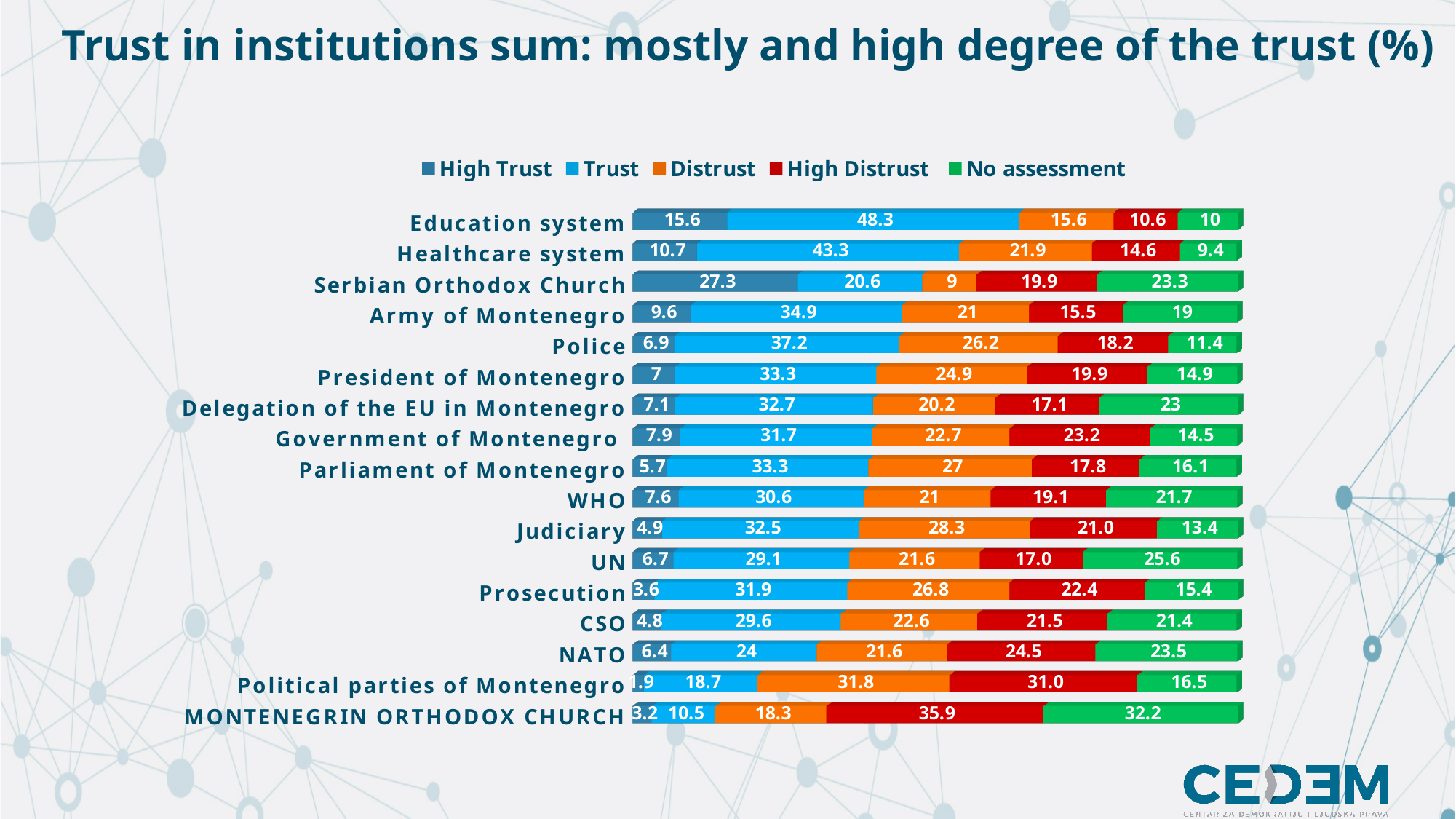
What is the total of the stacked bar for the Army of Montenegro? 100 How many series does the legend list? 5 How many institutions are shown in the chart? 17 What is the difference between the Trust value for the Education system and the Trust value for the Healthcare system? 5 Which is larger: the Distrust value for the Police or the Distrust value for the Army of Montenegro? Police What is the Trust value for the Education system? 48.3 What kind of chart is shown on the slide? Stacked bar chart Which colour represents the No assessment series in the legend? Green What is the No assessment value for the UN? 25.6 What is the High Distrust value for the Montenegrin Orthodox Church? 35.9 Which institution has the highest High Trust value? Serbian Orthodox Church Which institution has the lowest High Trust value? Political parties of Montenegro